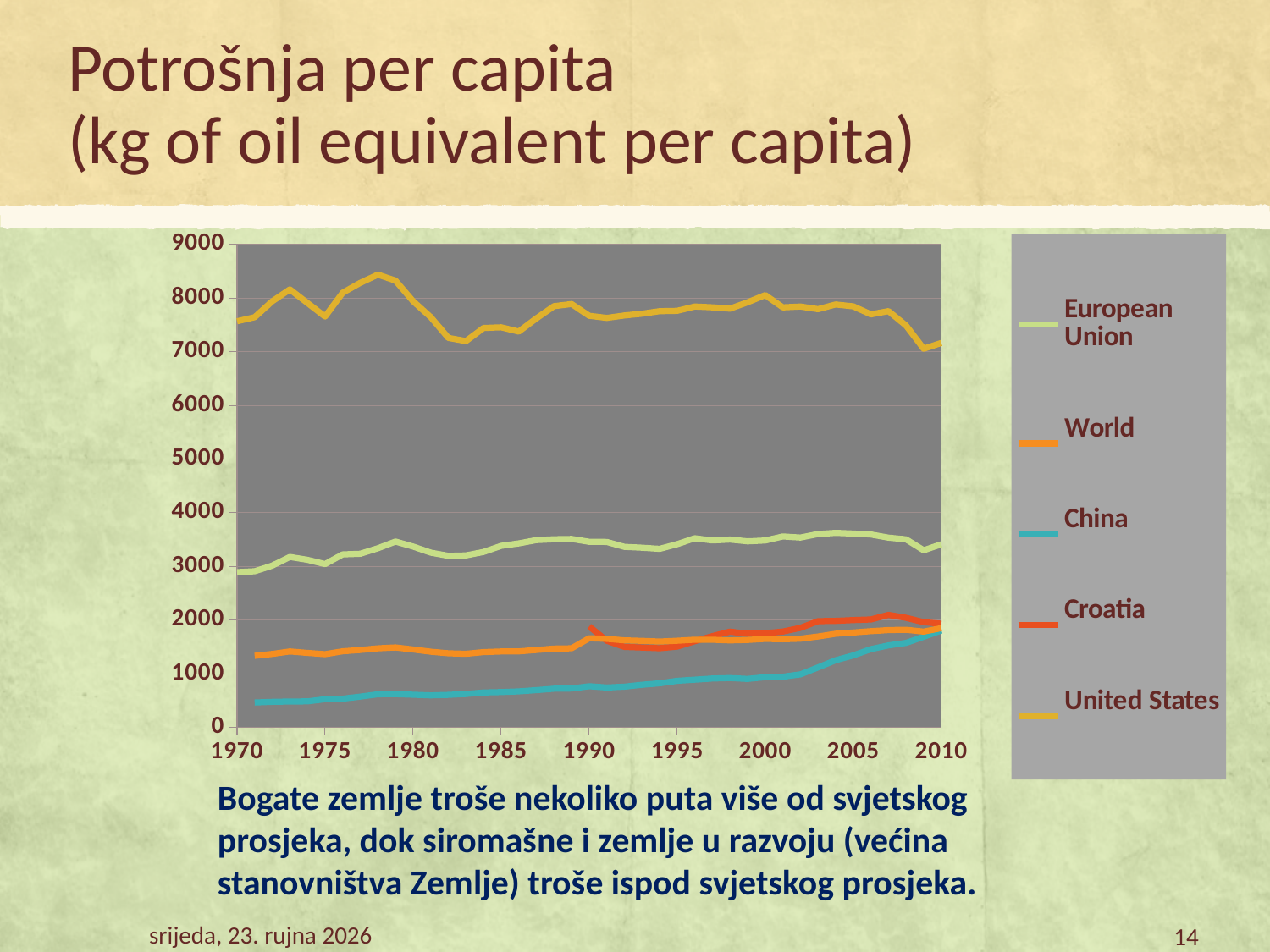
Which series has the highest values across the whole period? United States Is the value for United States in 1970 greater or less than 7000? greater What kind of chart is shown on the slide? line chart In 2000, which is larger, the value for European Union or the value for World? European Union Which series is drawn with the orange line? World Is the value for Croatia in 1995 greater or less than 2000? less Is the value for European Union in 2010 greater or less than 3000? greater Does the China line rise or fall from 1970 to 2010? rise Which series has the lowest values across the whole period? China Does the United States line rise or fall from 2005 to 2010? fall How many series does the legend list? 5